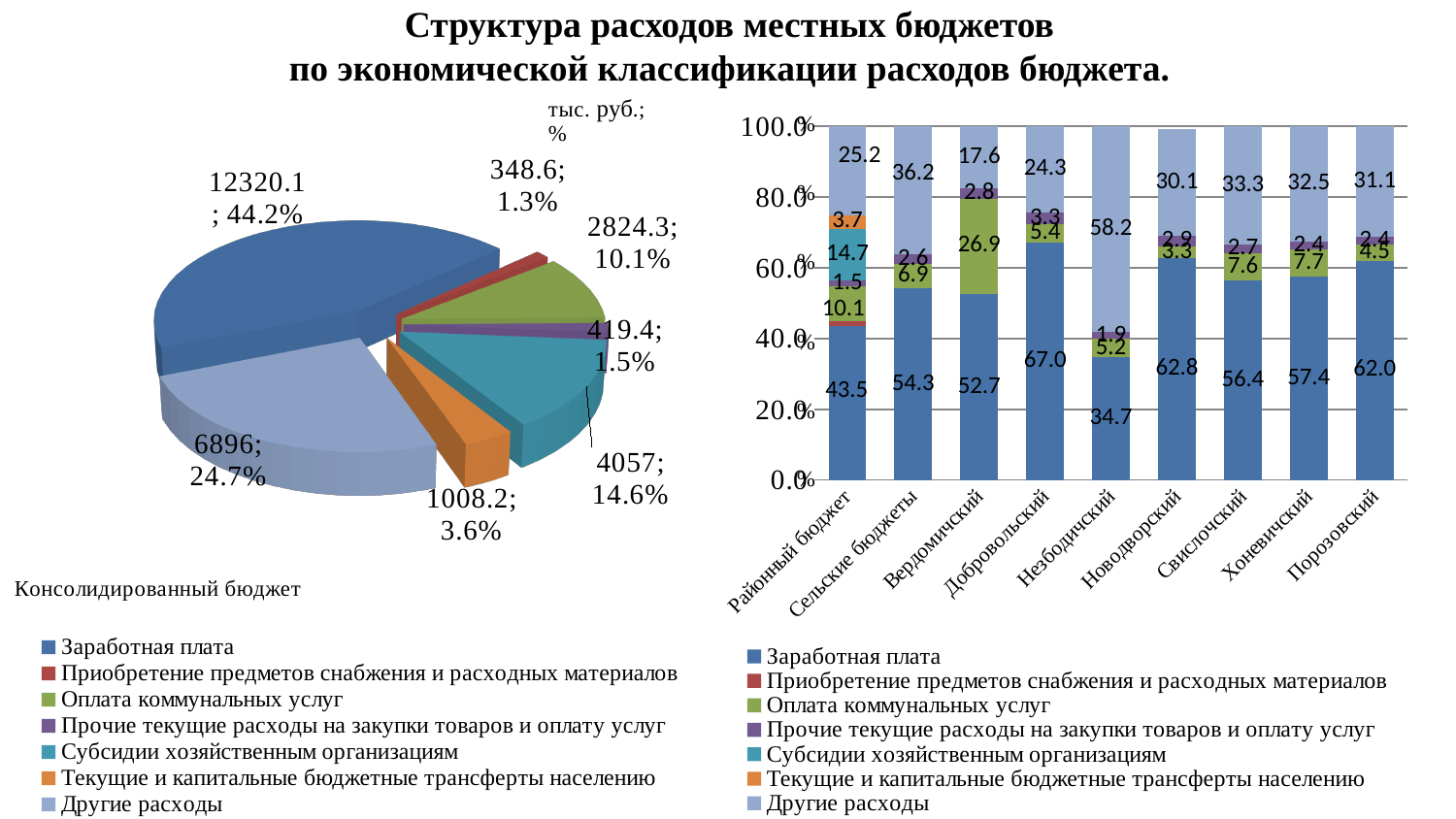
On the right stacked bar chart, how many categories are shown on the x axis? 9 What type of chart is shown on the right side of the slide? Stacked bar chart On the right stacked bar chart, what is the difference between the Заработная плата values for Порозовский and Районный бюджет? 18.5 On the left pie chart (Консолидированный бюджет), what share does Заработная плата have? 44.2% On the right stacked bar chart, which category has the highest Заработная плата value? Добровольский On the right stacked bar chart, what is the Заработная плата value for Незбодичский? 34.7 On the left pie chart (Консолидированный бюджет), which category has the smallest share? Приобретение предметов снабжения и расходных материалов On the right stacked bar chart, how many series does the legend list? 7 On the left pie chart (Консолидированный бюджет), what is the value in тыс. руб. for Другие расходы? 6896 On the left pie chart (Консолидированный бюджет), what is the value in тыс. руб. for Субсидии хозяйственным организациям? 4057 On the right stacked bar chart, which category has the highest Другие расходы value? Незбодичский On the left pie chart (Консолидированный бюджет), how many slices are there? 7